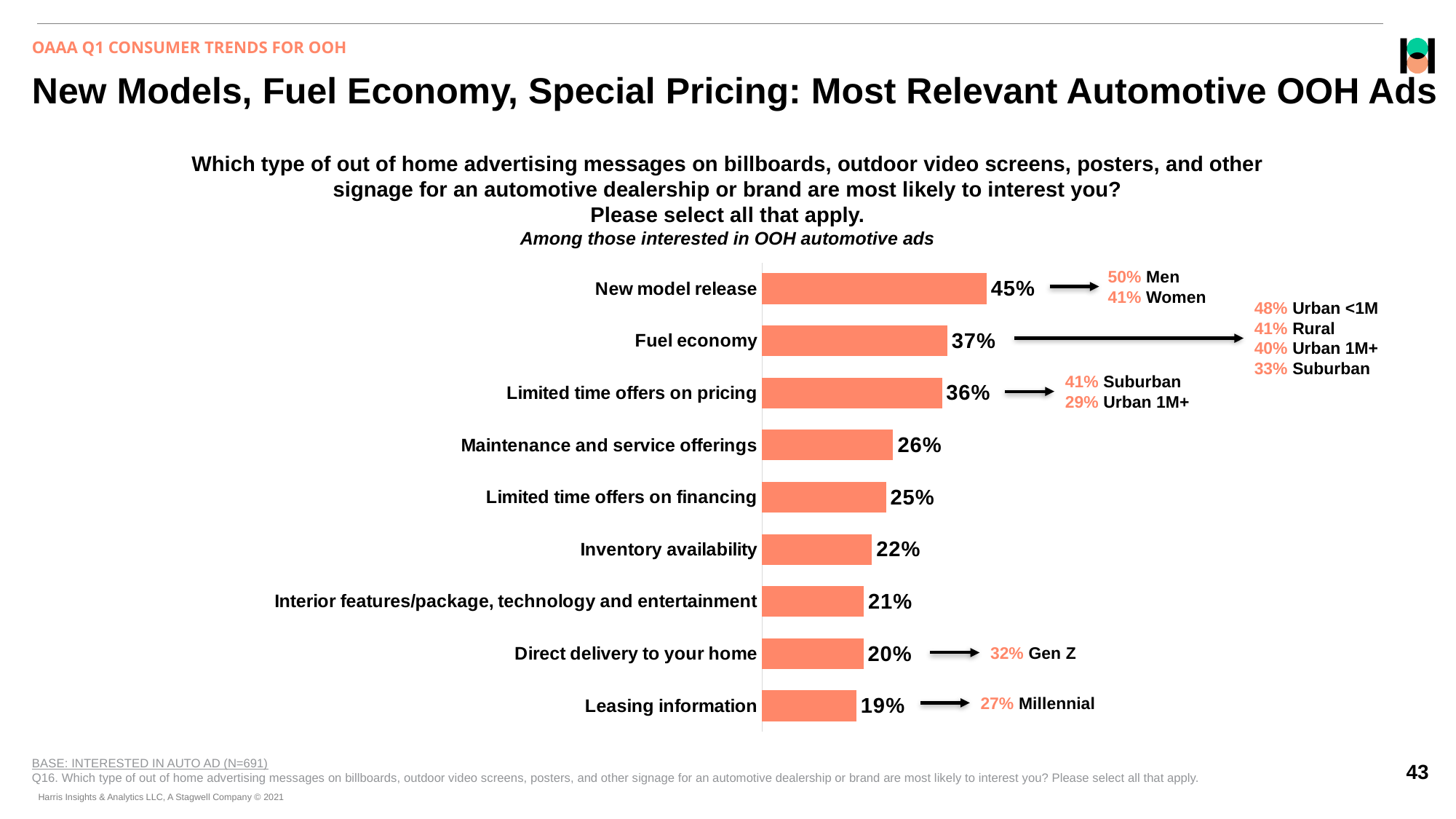
According to the callout, what percentage of Gen Z selected Direct delivery to your home? 32% According to the callout, what percentage of Men selected New model release? 50% What is the difference between the values for New model release and Fuel economy? 8% How many categories are shown in the chart? 9 What percentage of respondents selected Leasing information? 19% Which is larger, the value for Inventory availability or the value for Direct delivery to your home? Inventory availability What kind of chart is shown on the slide? Bar chart What percentage of respondents selected New model release? 45% What is the difference between the values for Limited time offers on pricing and Limited time offers on financing? 11% Which category has the lowest value? Leasing information What percentage of respondents selected Maintenance and service offerings? 26% Which category has the highest value? New model release